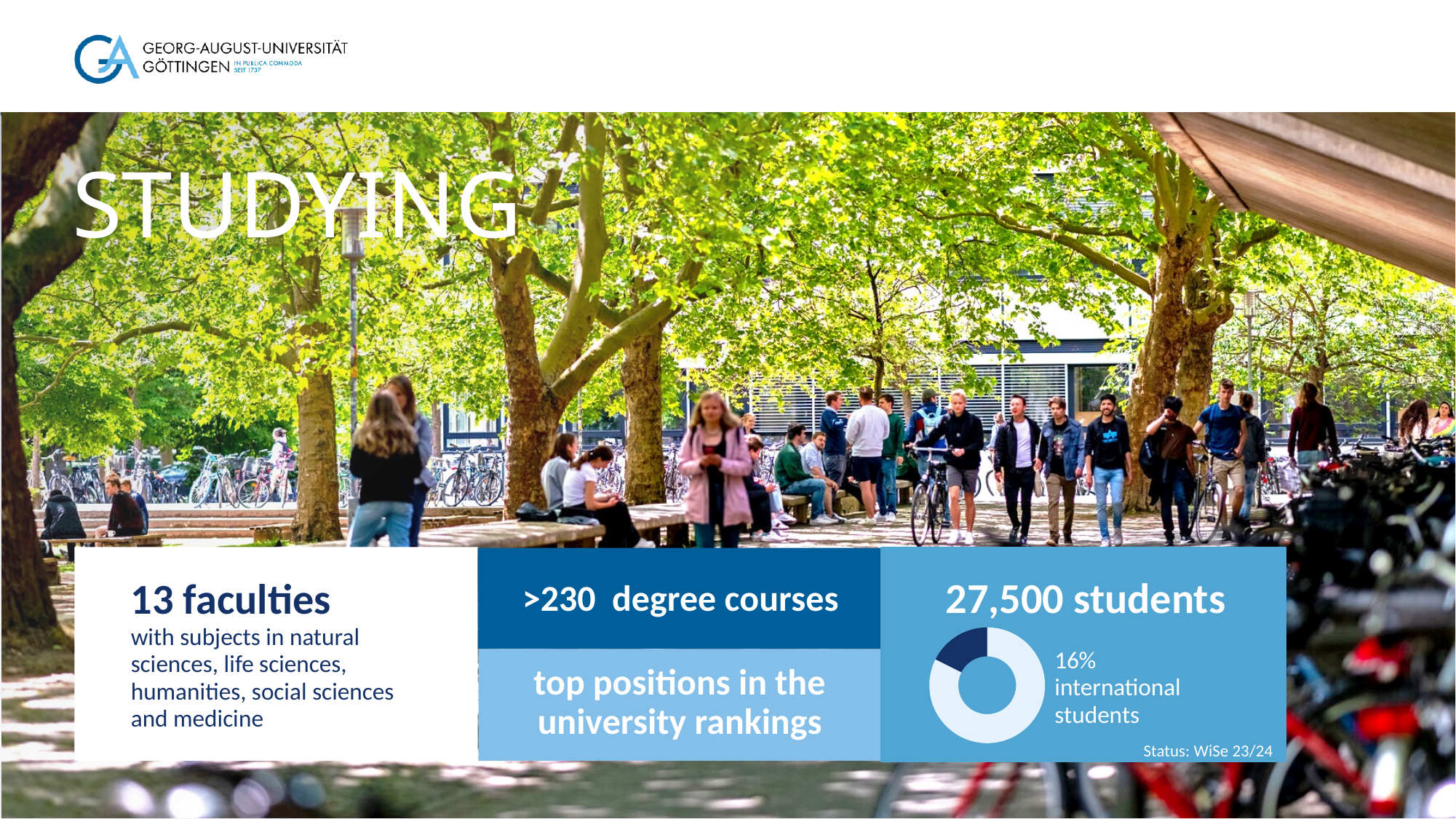
How many slices does the donut chart have? 2 Is the share of international students shown in the donut chart greater or less than 50%? less Which slice of the donut chart is larger, the dark blue (international students) slice or the light blue slice? The light blue slice What does the dark blue slice of the donut chart represent? International students What kind of chart is shown in the '27,500 students' box? Donut (pie) chart What share of students does the dark blue slice of the donut chart represent? 16% What status date is given for the donut chart data? WiSe 23/24